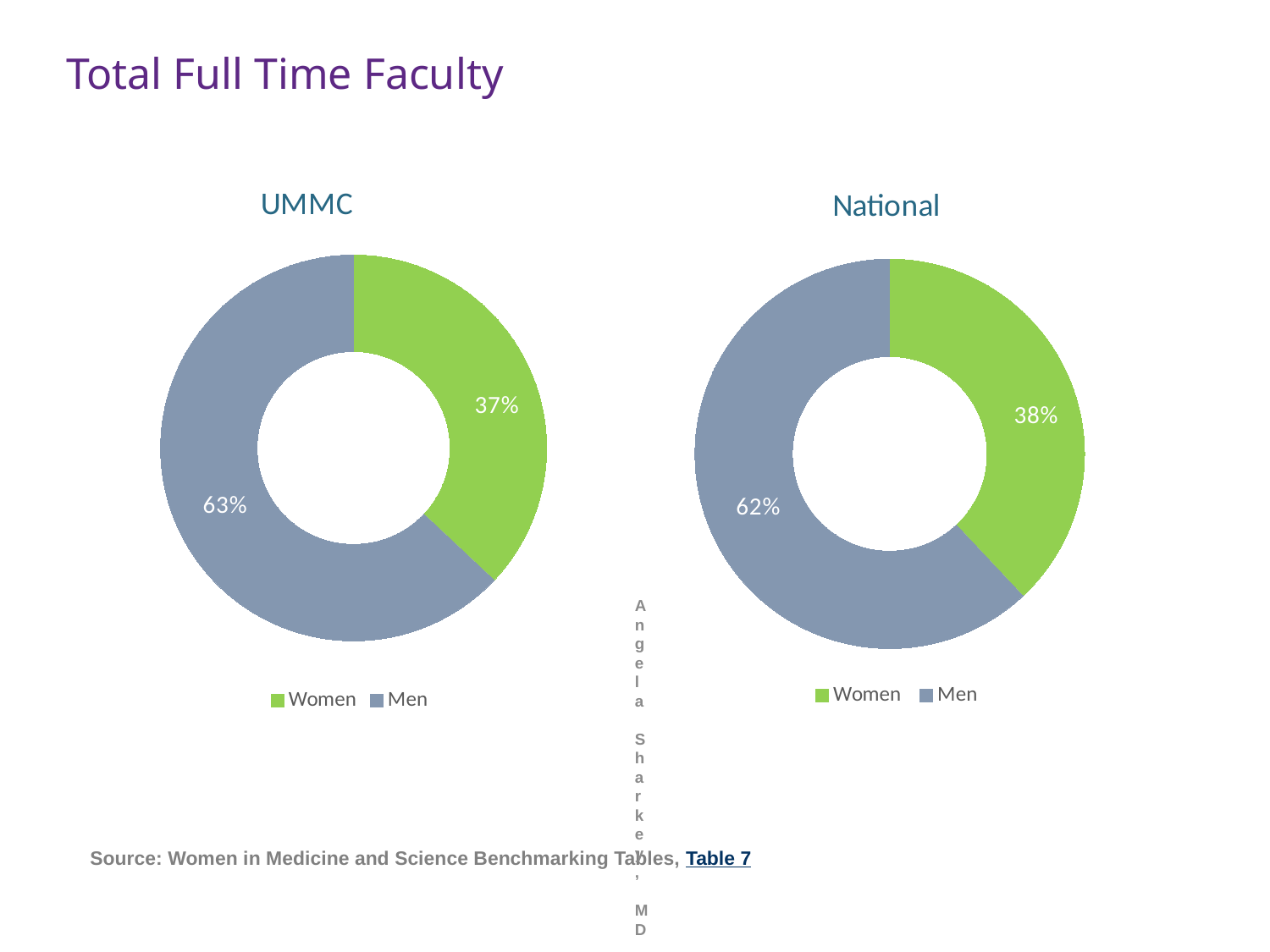
What is the title of the chart on the right side of the slide? National In the National chart, what is the difference in percentage points between men and women? 24 In the National chart, what percentage of full time faculty are women? 38% In the UMMC chart, what percentage of full time faculty are men? 63% In the National chart, which group has the smaller share? Women How many categories does the National chart show? 2 In the UMMC chart, what percentage of full time faculty are women? 37% In the UMMC chart, what is the difference in percentage points between men and women? 26 In the National chart, what percentage of full time faculty are men? 62% In the UMMC chart, what colour represents women? Green What type of chart is the UMMC chart? Doughnut chart In the UMMC chart, which group has the larger share, women or men? Men